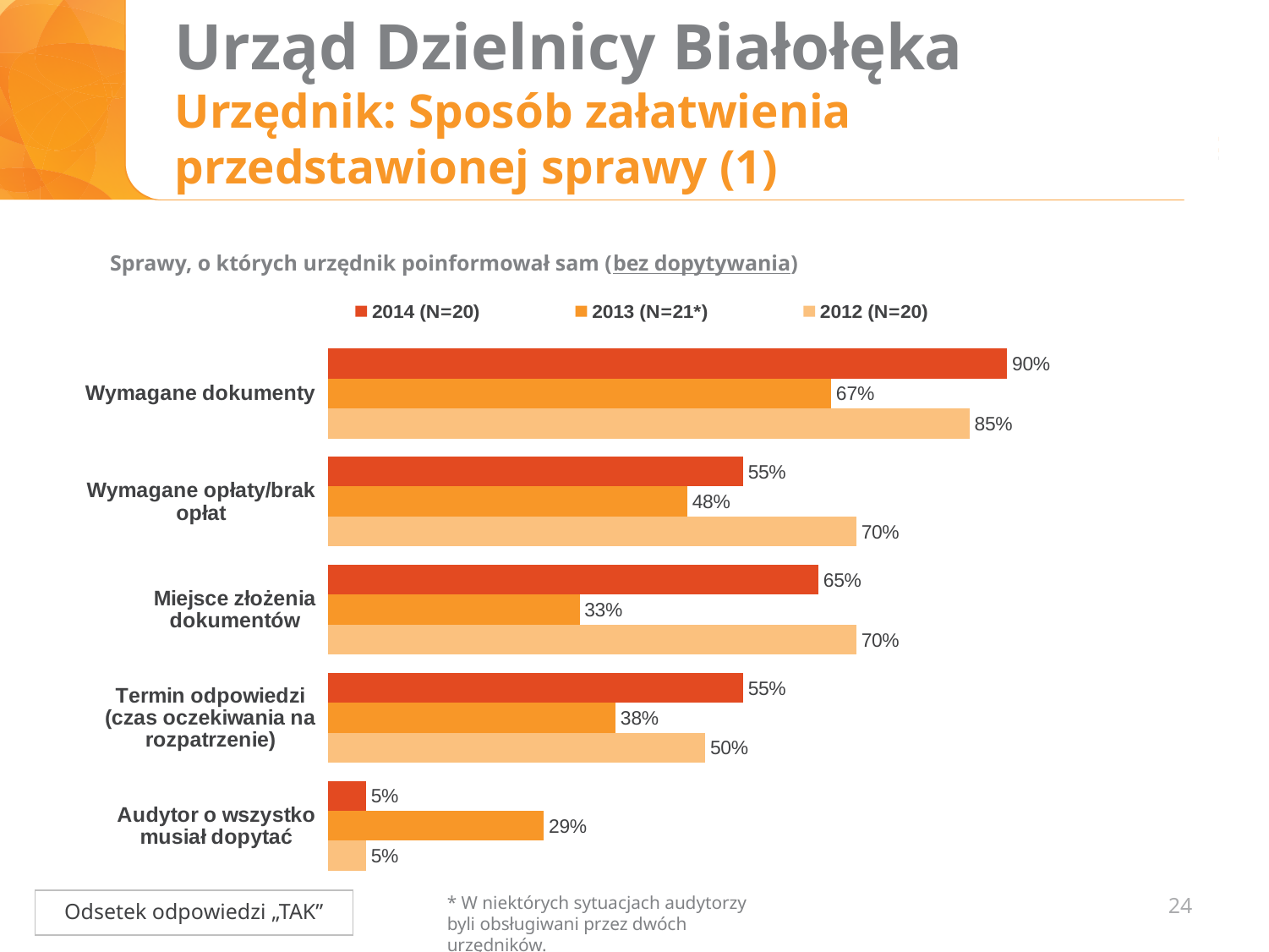
What is the value for "Termin odpowiedzi (czas oczekiwania na rozpatrzenie)" in the 2012 (N=20) series? 50% How many series does the legend list? 3 What is the difference between the 2014 (N=20) and 2013 (N=21*) values for "Wymagane dokumenty"? 23% Which category has the highest value in the 2014 (N=20) series? Wymagane dokumenty What kind of chart is shown on the slide? Bar chart What is the value for "Miejsce złożenia dokumentów" in the 2013 (N=21*) series? 33% How many categories are shown on the chart? 5 Which category has the lowest value in the 2013 (N=21*) series? Audytor o wszystko musiał dopytać What is the subtitle printed above the chart? Sprawy, o których urzędnik poinformował sam (bez dopytywania) Which is larger for "Wymagane opłaty/brak opłat": the 2014 (N=20) value or the 2012 (N=20) value? 2012 (N=20) What is the difference between the 2013 (N=21*) and 2012 (N=20) values for "Audytor o wszystko musiał dopytać"? 24% What is the value for "Wymagane dokumenty" in the 2014 (N=20) series? 90%